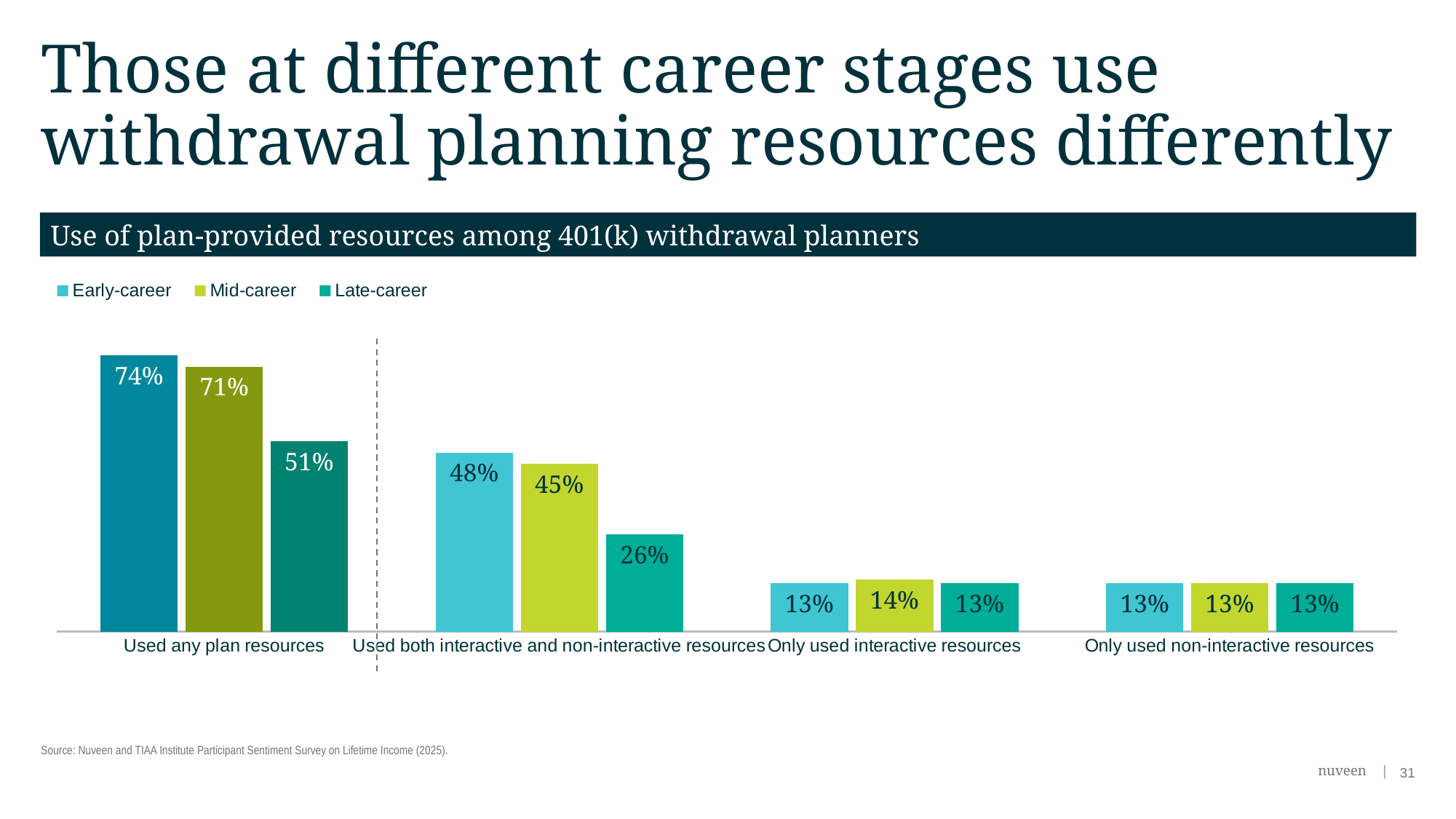
Which career stage has the highest value for "Used both interactive and non-interactive resources"? Early-career Which is larger: the Early-career value for "Used any plan resources" or the Mid-career value for "Used any plan resources"? Early-career How many categories are shown on the x axis? 4 What is the Early-career value for "Used any plan resources"? 74% What is the difference between the Early-career and Late-career values for "Used any plan resources"? 23% What is the Late-career value for "Used both interactive and non-interactive resources"? 26% How many series does the legend list? 3 What is the Mid-career value for "Only used interactive resources"? 14% What kind of chart is shown on the slide? Bar chart What is the title of the chart? Use of plan-provided resources among 401(k) withdrawal planners What is the difference between the Mid-career and Late-career values for "Used both interactive and non-interactive resources"? 19% Which career stage has the lowest value for "Used any plan resources"? Late-career